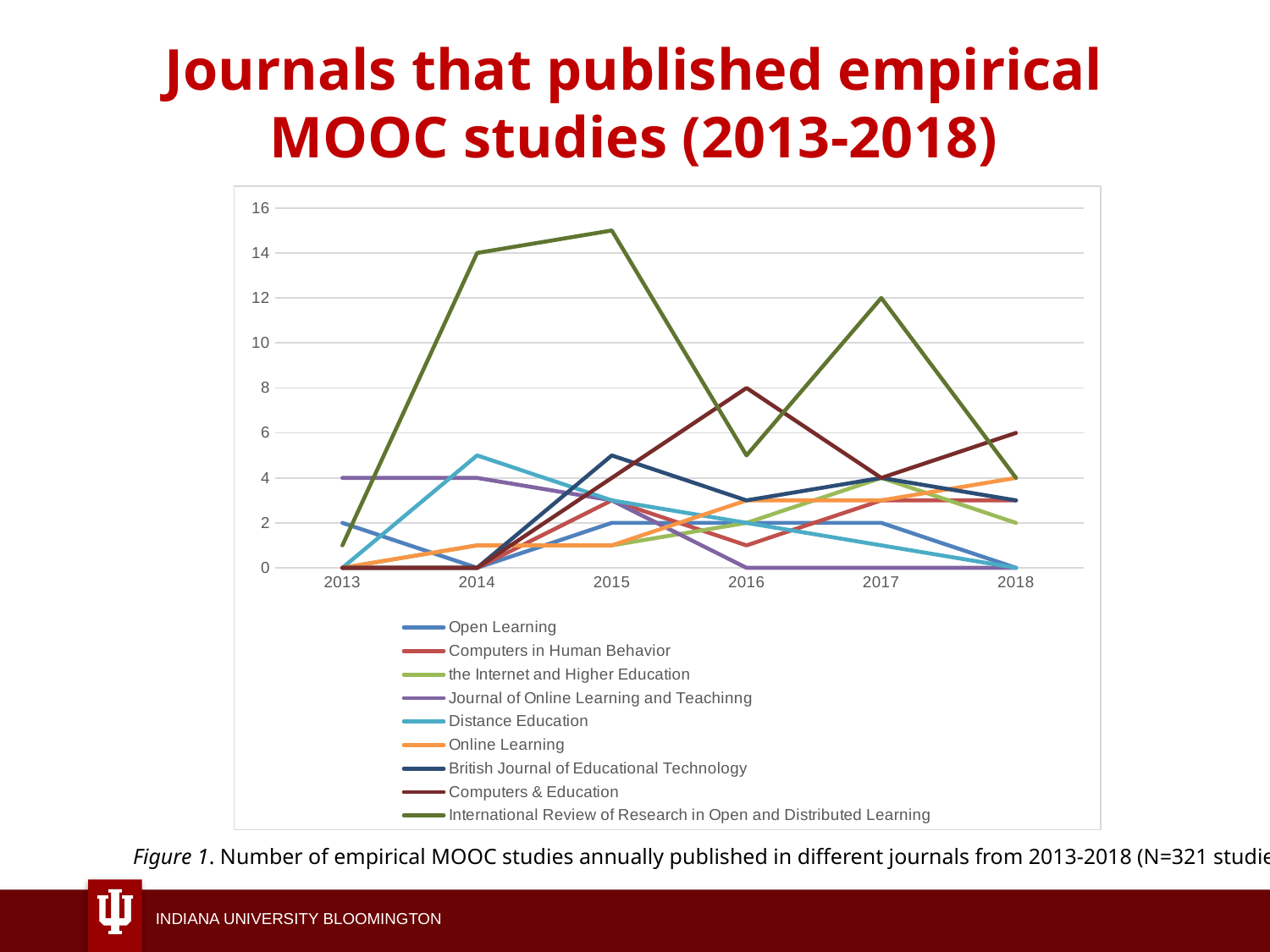
What type of chart is shown on the slide? line chart How many studies did the International Review of Research in Open and Distributed Learning publish in 2014? 14 Is the value for the International Review of Research in Open and Distributed Learning in 2017 greater or less than 10? greater In which year did the International Review of Research in Open and Distributed Learning publish the most empirical MOOC studies? 2015 How many studies did Computers & Education publish in 2016? 8 How many journals (series) does the legend list? 9 What is the title of the chart on the slide? Journals that published empirical MOOC studies (2013-2018) How many years are shown along the x axis? 6 Which journal had the higher value in 2016: Computers & Education or Distance Education? Computers & Education Did the Journal of Online Learning and Teaching's values rise or fall from 2014 to 2016? fall